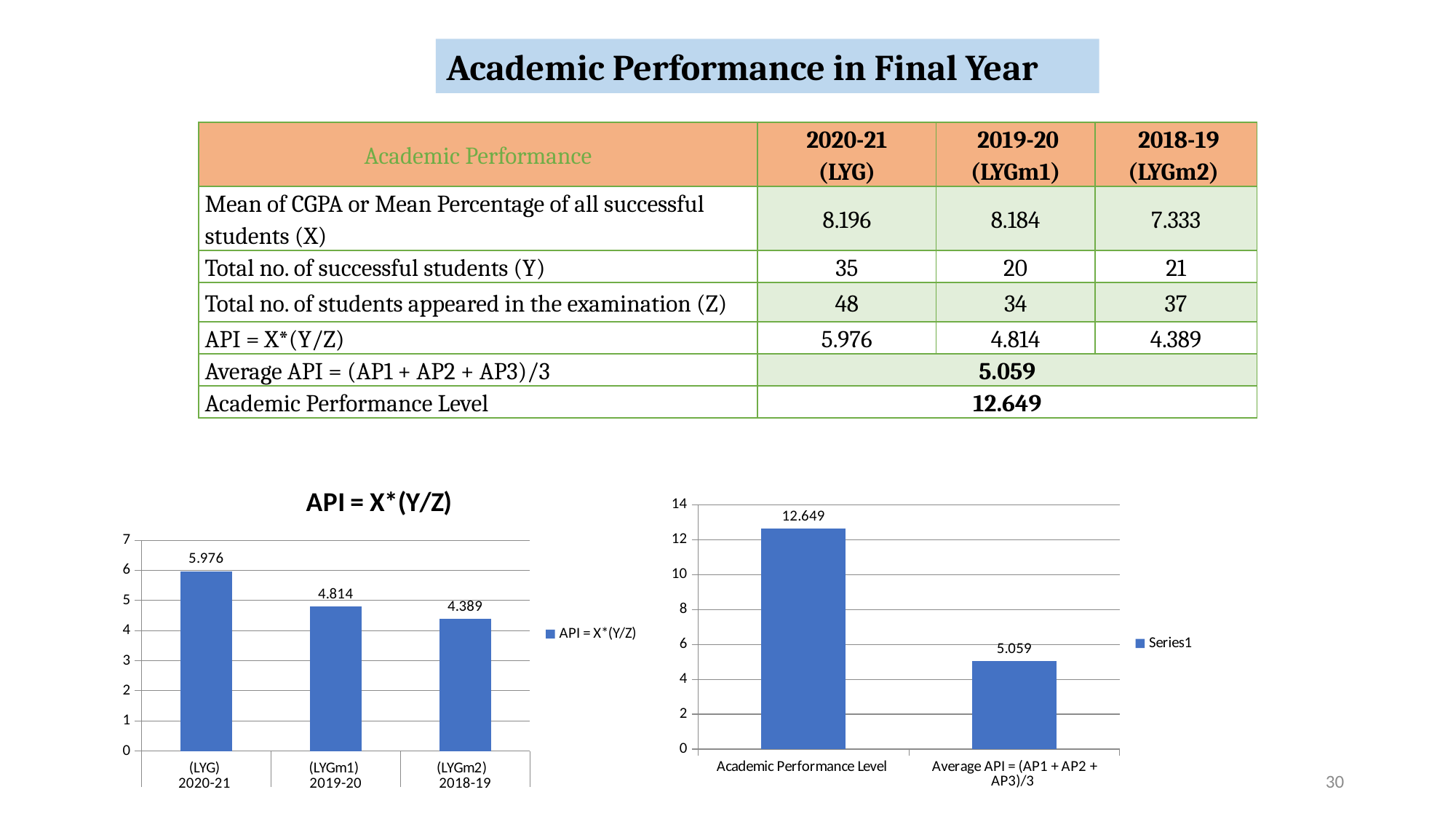
In the chart titled "API = X*(Y/Z)", which category has the highest value? (LYG) 2020-21 In the chart titled "API = X*(Y/Z)", what is the value for (LYGm2) 2018-19? 4.389 In the chart on the right of the slide, which is larger: Academic Performance Level or Average API = (AP1 + AP2 + AP3)/3? Academic Performance Level In the chart on the right of the slide, what is the value for Average API = (AP1 + AP2 + AP3)/3? 5.059 In the chart titled "API = X*(Y/Z)", what is the difference between the values for (LYG) 2020-21 and (LYGm1) 2019-20? 1.162 What kind of chart is the chart titled "API = X*(Y/Z)"? bar chart In the chart titled "API = X*(Y/Z)", which category has the lowest value? (LYGm2) 2018-19 In the chart titled "API = X*(Y/Z)", do the values rise or fall from left to right along the x axis? fall In the chart on the right of the slide, what is the name of the series shown in the legend? Series1 In the chart titled "API = X*(Y/Z)", what is the value for (LYG) 2020-21? 5.976 In the chart titled "API = X*(Y/Z)", how many categories are plotted? 3 In the chart on the right of the slide, what is the value for Academic Performance Level? 12.649